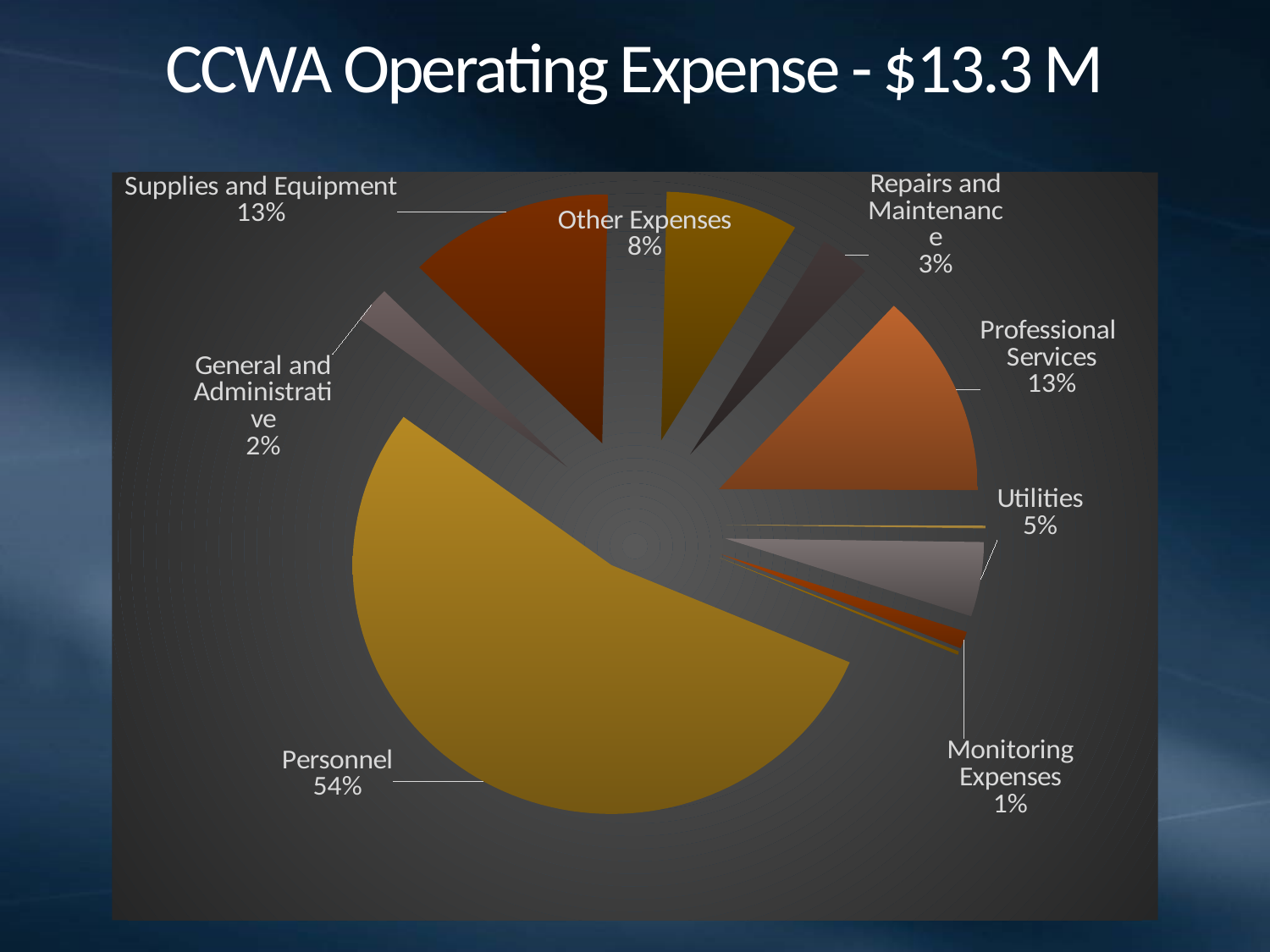
What percentage is shown for Other Expenses? 8% Which is larger, the share for Utilities or the share for General and Administrative? Utilities What kind of chart is shown on the slide? pie chart Which category has the largest share of the pie? Personnel What percentage is shown for Repairs and Maintenance? 3% What share of the pie does Personnel represent? 54% What is the difference in percentage points between Personnel and Supplies and Equipment? 41 What is the title of the chart on the slide? CCWA Operating Expense - $13.3 M What percentage is shown for Utilities? 5% What is the difference in percentage points between Other Expenses and Repairs and Maintenance? 5